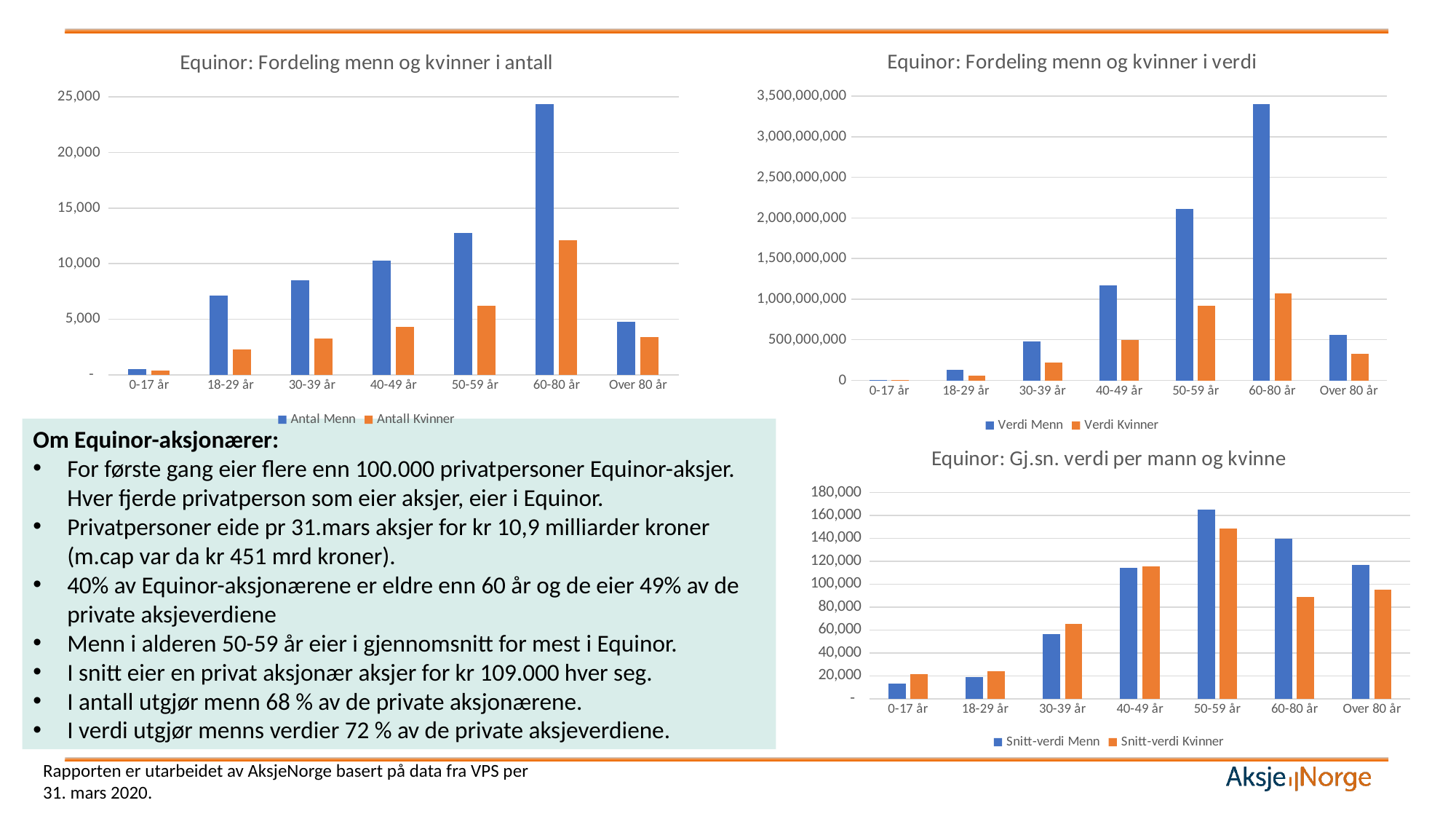
In the chart titled 'Equinor: Fordeling menn og kvinner i verdi', which age group has the lowest value for Verdi Kvinner? 0-17 år In the chart titled 'Equinor: Gj.sn. verdi per mann og kvinne', which is larger for the 30-39 år group: Snitt-verdi Menn or Snitt-verdi Kvinner? Snitt-verdi Kvinner In the chart titled 'Equinor: Gj.sn. verdi per mann og kvinne', is the value for Snitt-verdi Kvinner in the 60-80 år group greater or less than 100,000? less What kind of chart is the one titled 'Equinor: Gj.sn. verdi per mann og kvinne'? bar chart In the chart titled 'Equinor: Gj.sn. verdi per mann og kvinne', which age group has the highest value for Snitt-verdi Menn? 50-59 år In the chart titled 'Equinor: Fordeling menn og kvinner i antall', is the value for Antal Menn in the 60-80 år group greater or less than 20,000? greater In the chart titled 'Equinor: Fordeling menn og kvinner i antall', is the value for Antall Kvinner in the 60-80 år group greater or less than 10,000? greater In the chart titled 'Equinor: Fordeling menn og kvinner i antall', which age group has the highest value for Antal Menn? 60-80 år How many age groups are shown on the x axis of the chart titled 'Equinor: Fordeling menn og kvinner i antall'? 7 How many series does the legend list in the chart titled 'Equinor: Fordeling menn og kvinner i verdi'? 2 In the chart titled 'Equinor: Fordeling menn og kvinner i verdi', which age group has the highest value for Verdi Menn? 60-80 år